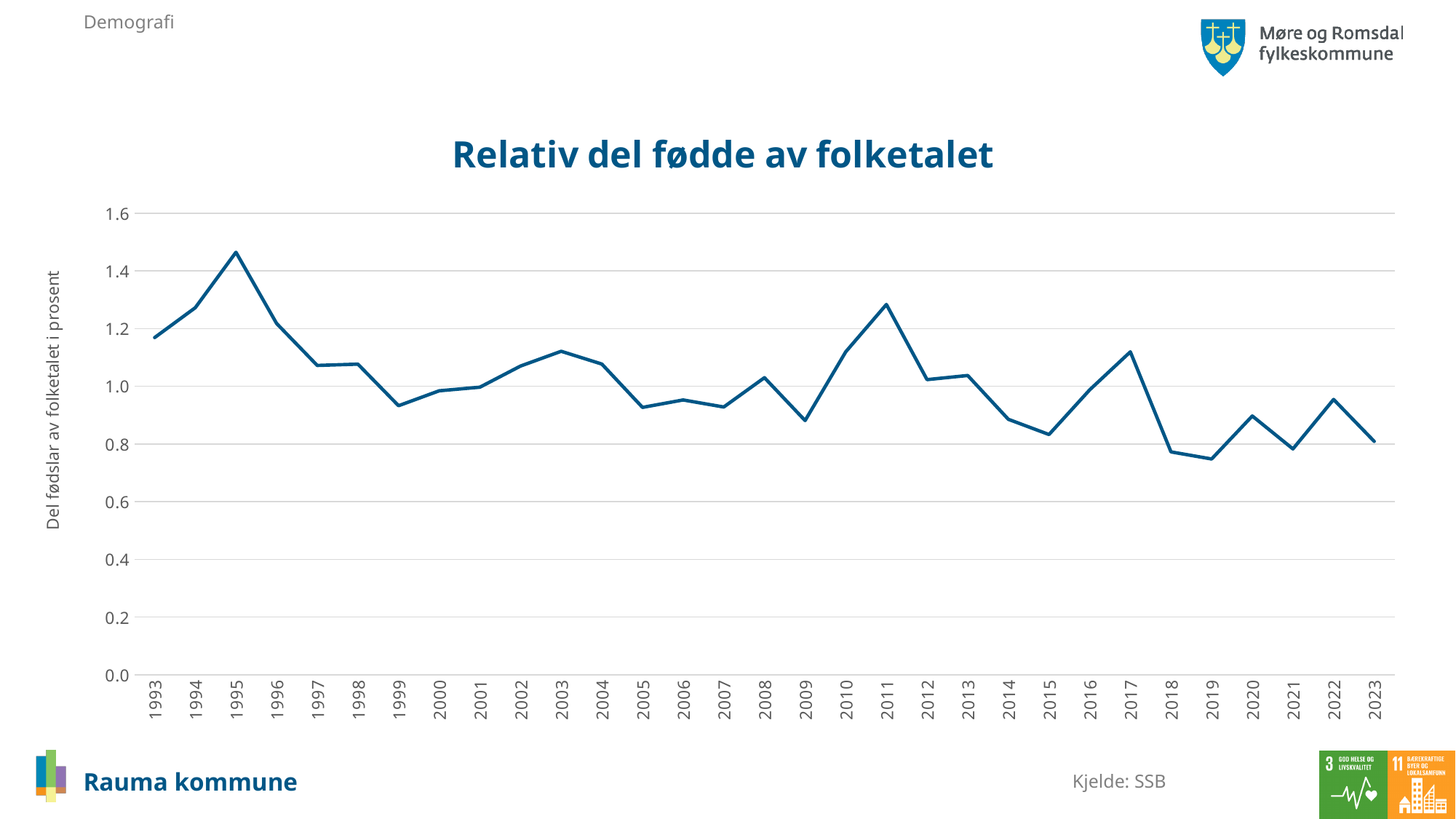
Is the value for 2011 greater or less than 1.2? greater Which year has the larger value, 2017 or 2020? 2017 What is the title of the chart? Relativ del fødde av folketalet Is the value for 2014 greater or less than 1.0? less Is the value for 1995 greater or less than 1.4? greater How many years are plotted along the x axis of the chart? 31 Does the line generally rise or fall from 1993 to 2023? Fall In which year does the line reach its highest value? 1995 What is the label on the vertical axis of the chart? Del fødslar av folketalet i prosent What kind of chart is shown on the slide? Line chart Which year has the larger value, 1995 or 2011? 1995